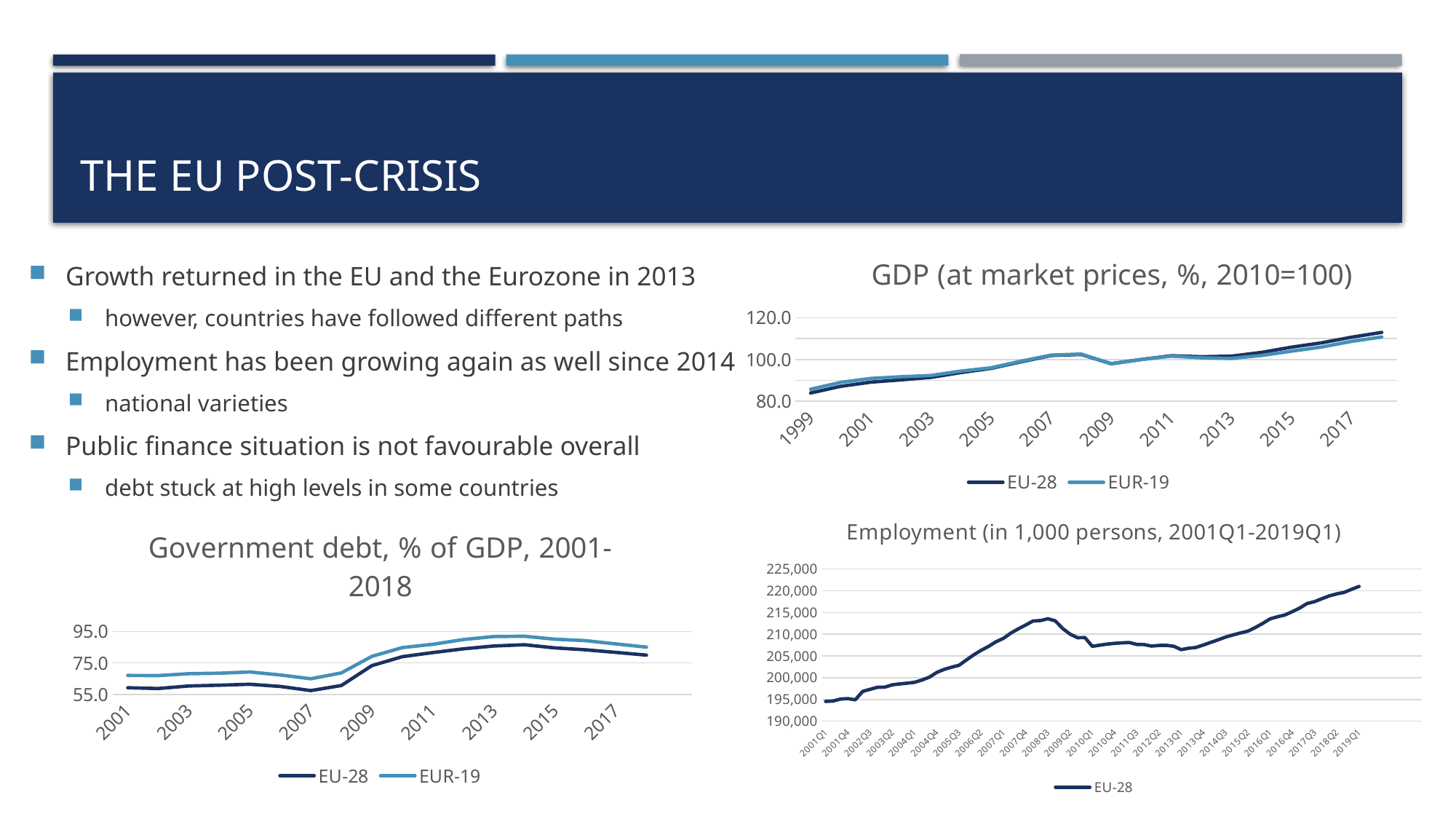
What kind of chart is the 'GDP (at market prices, %, 2010=100)' chart? line chart In the 'Government debt, % of GDP, 2001-2018' chart, is the EU-28 value for 2001 greater or less than 75.0? less How many series does the legend of the 'Employment (in 1,000 persons, 2001Q1-2019Q1)' chart list? 1 In the 'GDP (at market prices, %, 2010=100)' chart, do the values generally rise or fall from 1999 to 2018? rise In the 'Government debt, % of GDP, 2001-2018' chart, do the values rise or fall between 2007 and 2013? rise In the 'GDP (at market prices, %, 2010=100)' chart, is the EU-28 value for 2017 greater or less than 100.0? greater What kind of chart is the 'Government debt, % of GDP, 2001-2018' chart? line chart In the 'Government debt, % of GDP, 2001-2018' chart, which series is higher in 2013, EU-28 or EUR-19? EUR-19 How many series does the legend of the 'GDP (at market prices, %, 2010=100)' chart list? 2 In the 'GDP (at market prices, %, 2010=100)' chart, is the EU-28 value for 1999 greater or less than 100.0? less How many charts are shown on the slide? 3